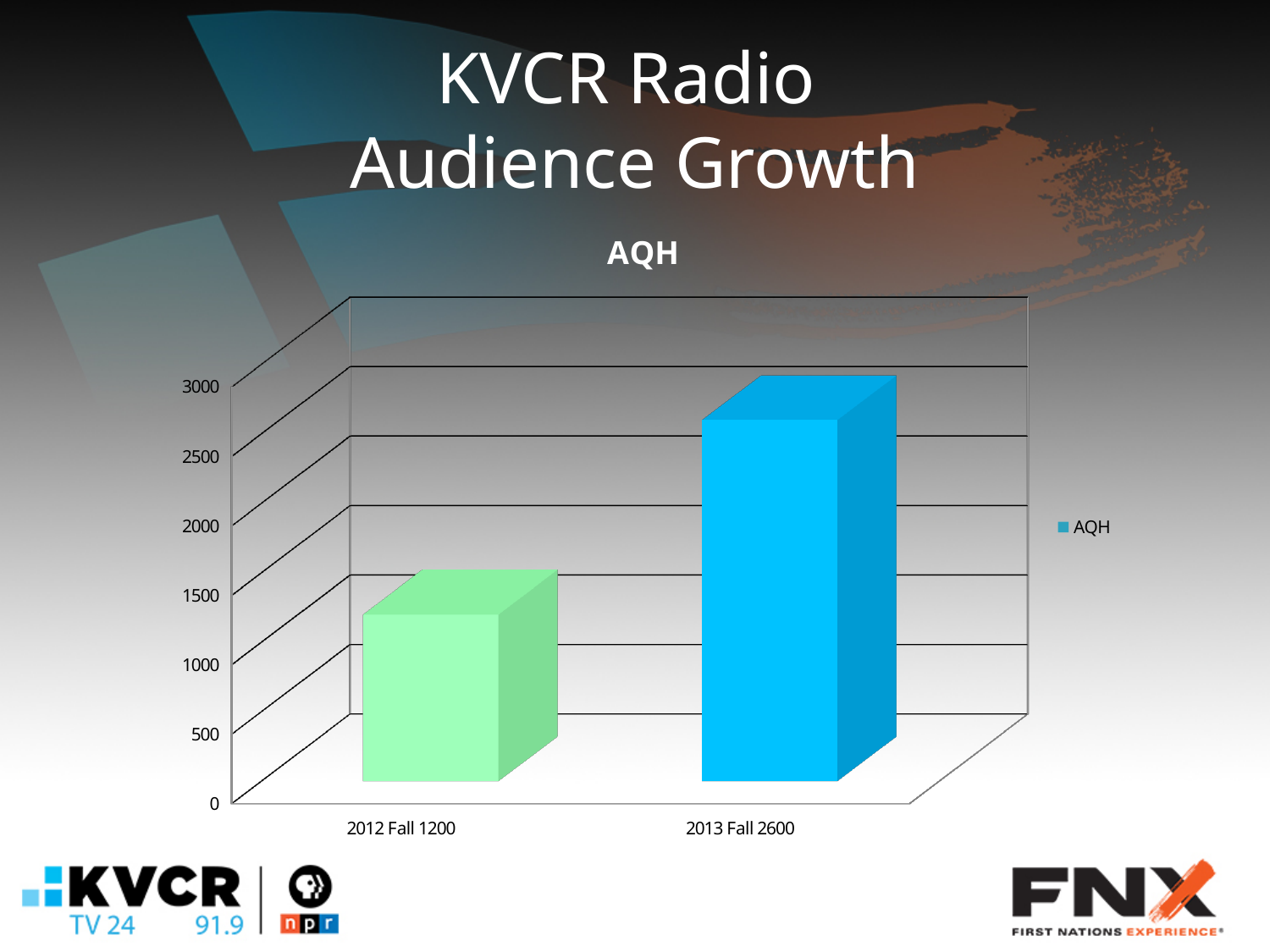
Which category has the lowest AQH value? 2012 Fall What kind of chart is shown on the slide? bar chart Is the value for 2013 Fall greater or less than 2000? greater Which category has the highest AQH value? 2013 Fall How many series does the legend list? 1 Which is larger, the AQH value for 2012 Fall or for 2013 Fall? 2013 Fall Do the AQH values rise or fall from 2012 Fall to 2013 Fall? rise What is the title of the chart? AQH What is the AQH value for 2012 Fall? 1200 What is the AQH value for 2013 Fall? 2600 How many bars (categories) does the chart show? 2 What is the difference between the AQH values for 2013 Fall and 2012 Fall? 1400